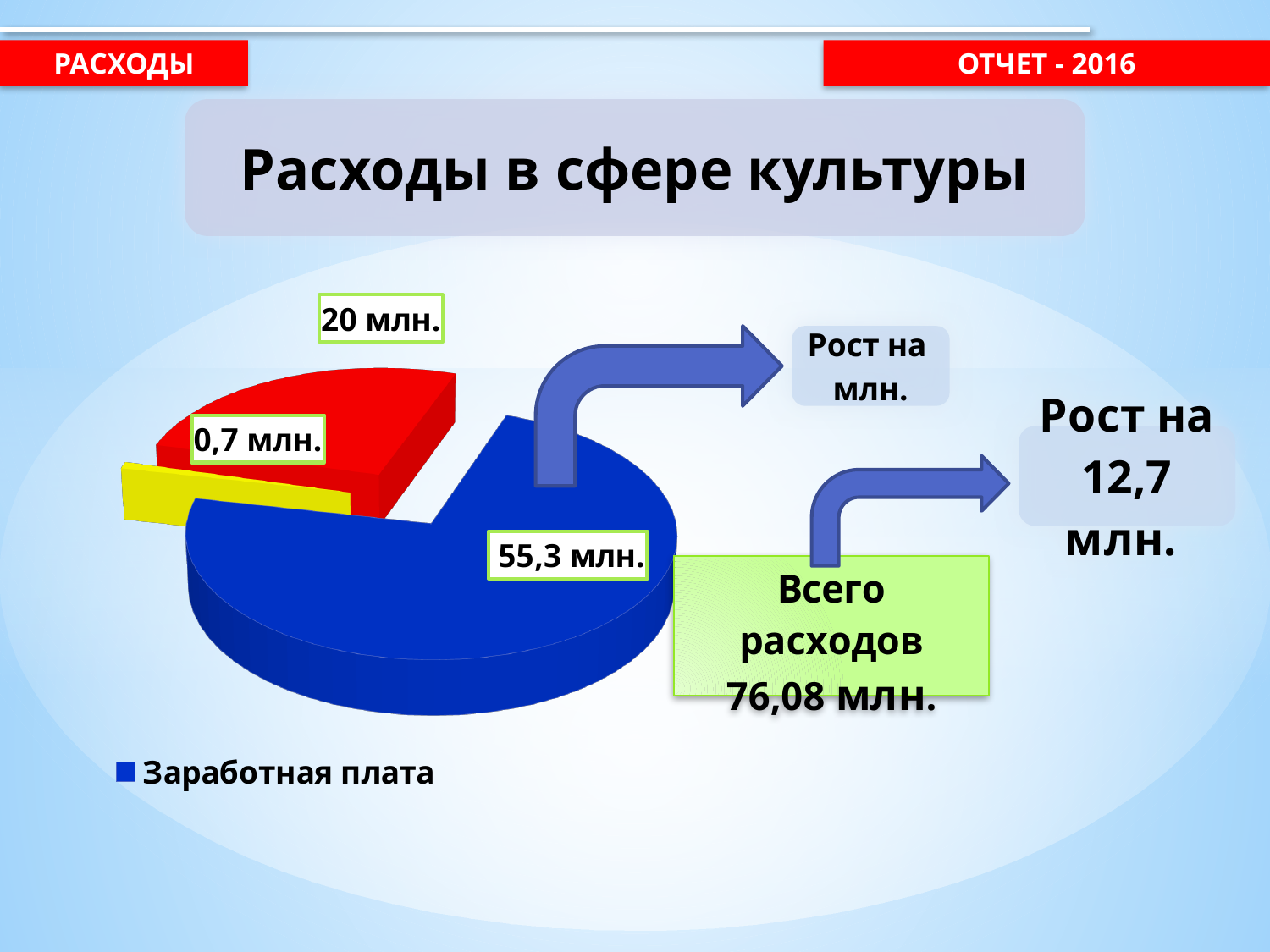
Which slice of the pie chart is the smallest? The yellow slice (0,7 млн.) Which is larger: the Заработная плата slice or the red slice? Заработная плата How many slices does the pie chart have? 3 What kind of chart is shown on the slide? Pie chart What value is labelled on the red slice of the pie chart? 20 млн. How many entries does the chart legend list? 1 Which slice of the pie chart is the largest? Заработная плата (blue, 55,3 млн.) What value is labelled on the yellow slice of the pie chart? 0,7 млн. What is the title of the chart on the slide? Расходы в сфере культуры What is the difference between the red slice and the yellow slice? 19,3 млн. What is the value of the Заработная плата slice in the pie chart? 55,3 млн. What is the difference between the Заработная плата slice and the red slice? 35,3 млн.